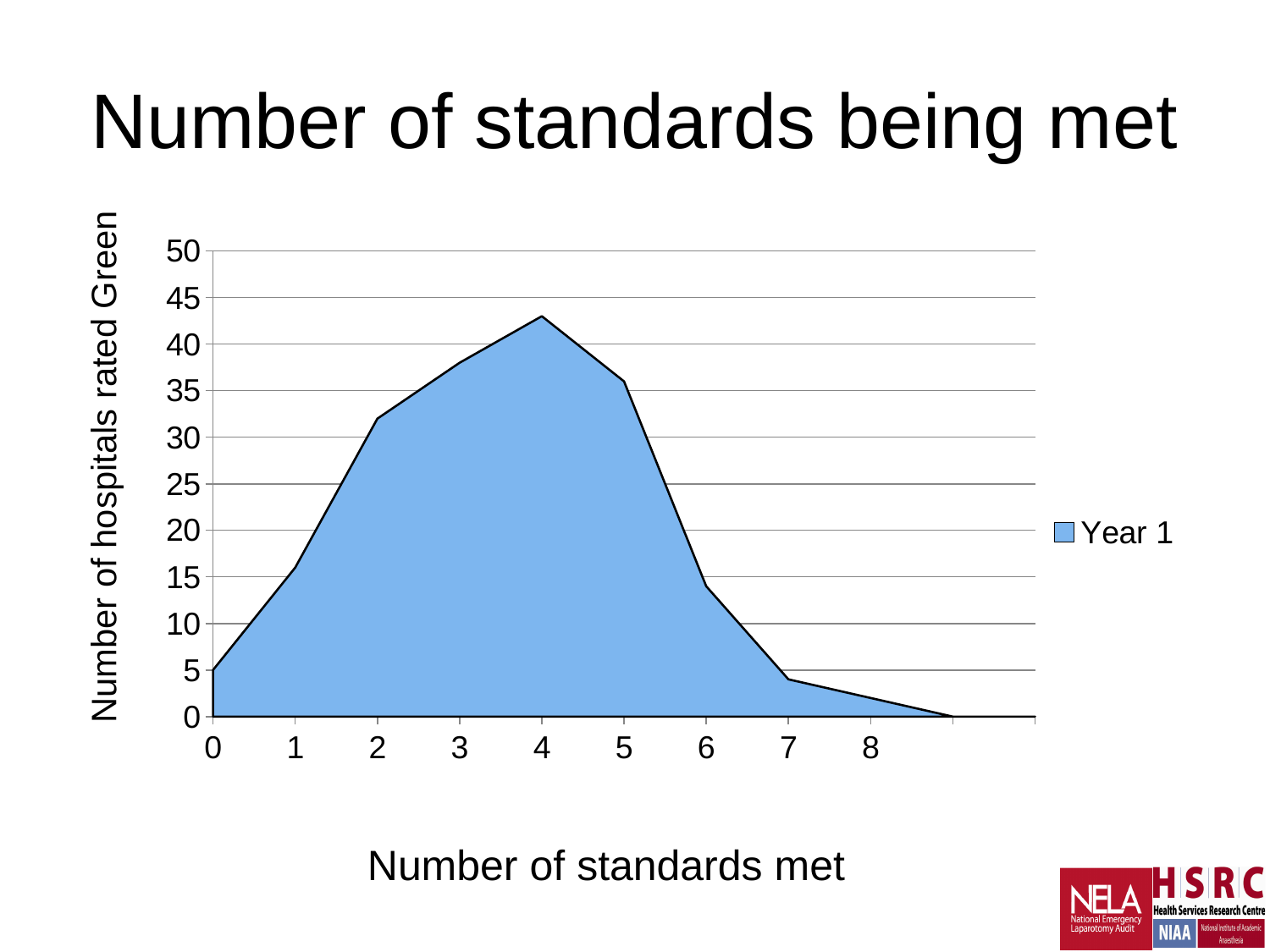
Among the labelled x-axis values 0 to 8, which has the lowest number of hospitals rated Green? 8 What kind of chart is shown on the slide? Area chart What is the name of the series shown in the legend? Year 1 How many series does the legend list? 1 What is the number of hospitals rated Green for 0 standards met? 5 How does the number of hospitals rated Green change as the number of standards met goes from 4 to 8? It falls Is the value for 2 standards met greater or less than 30? greater Is the value for 4 standards met greater or less than 40? greater What is the title of the chart? Number of standards being met Which has more hospitals rated Green: 2 standards met or 6 standards met? 2 standards met At which number of standards met is the number of hospitals rated Green highest? 4